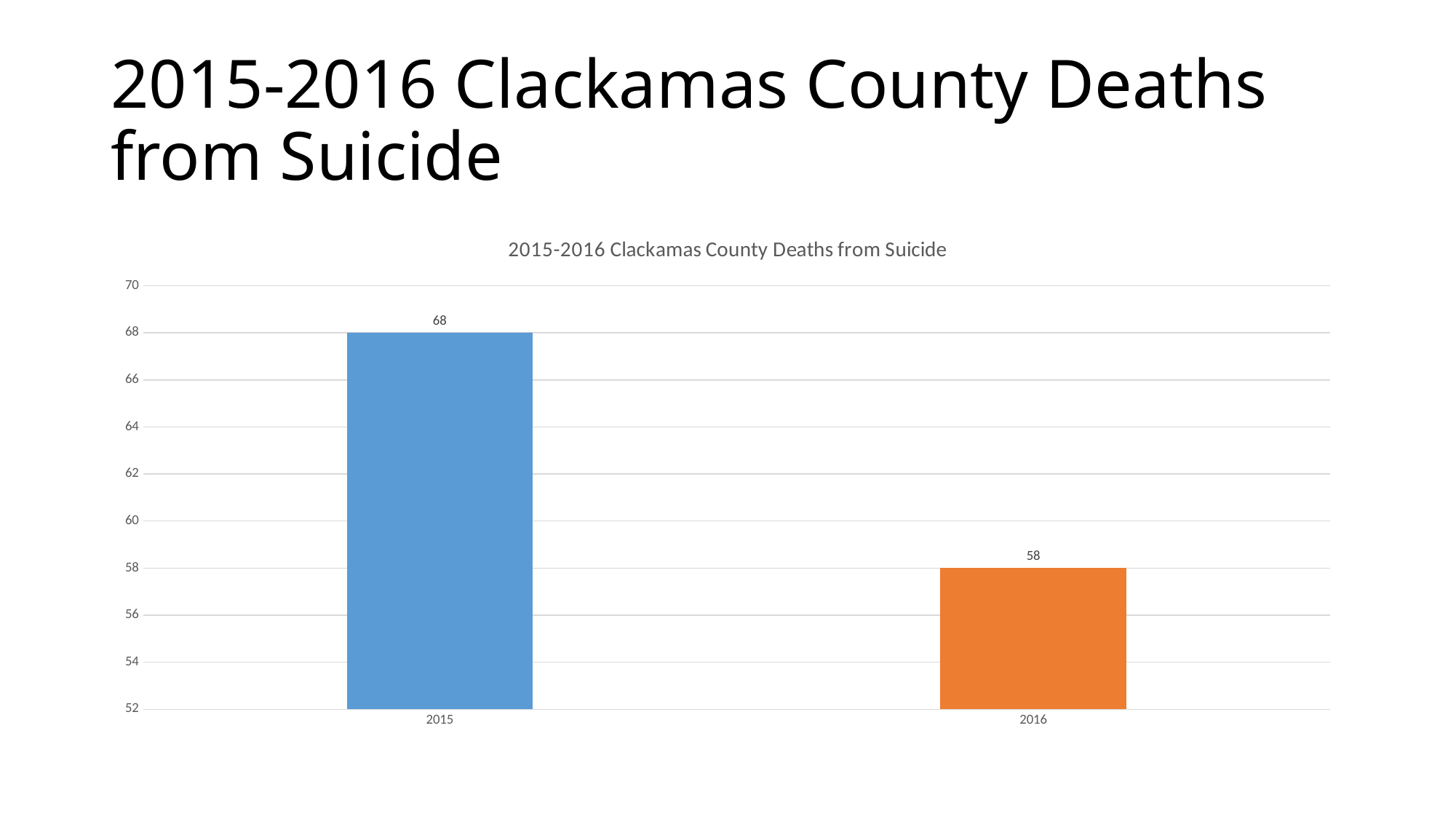
Is the value for 2016 greater or less than 60? less Is the value for 2015 greater or less than 64? greater Which year has the lower number of deaths from suicide? 2016 Do the values rise or fall from 2015 to 2016? fall What kind of chart is shown on the slide? bar chart Is the value for 2015 larger or smaller than the value for 2016? larger What is the title of the chart? 2015-2016 Clackamas County Deaths from Suicide Which year has the higher number of deaths from suicide? 2015 What is the difference between the 2015 and 2016 values? 10 What is the number of deaths from suicide in Clackamas County in 2016? 58 How many years are shown on the chart? 2 What is the number of deaths from suicide in Clackamas County in 2015? 68